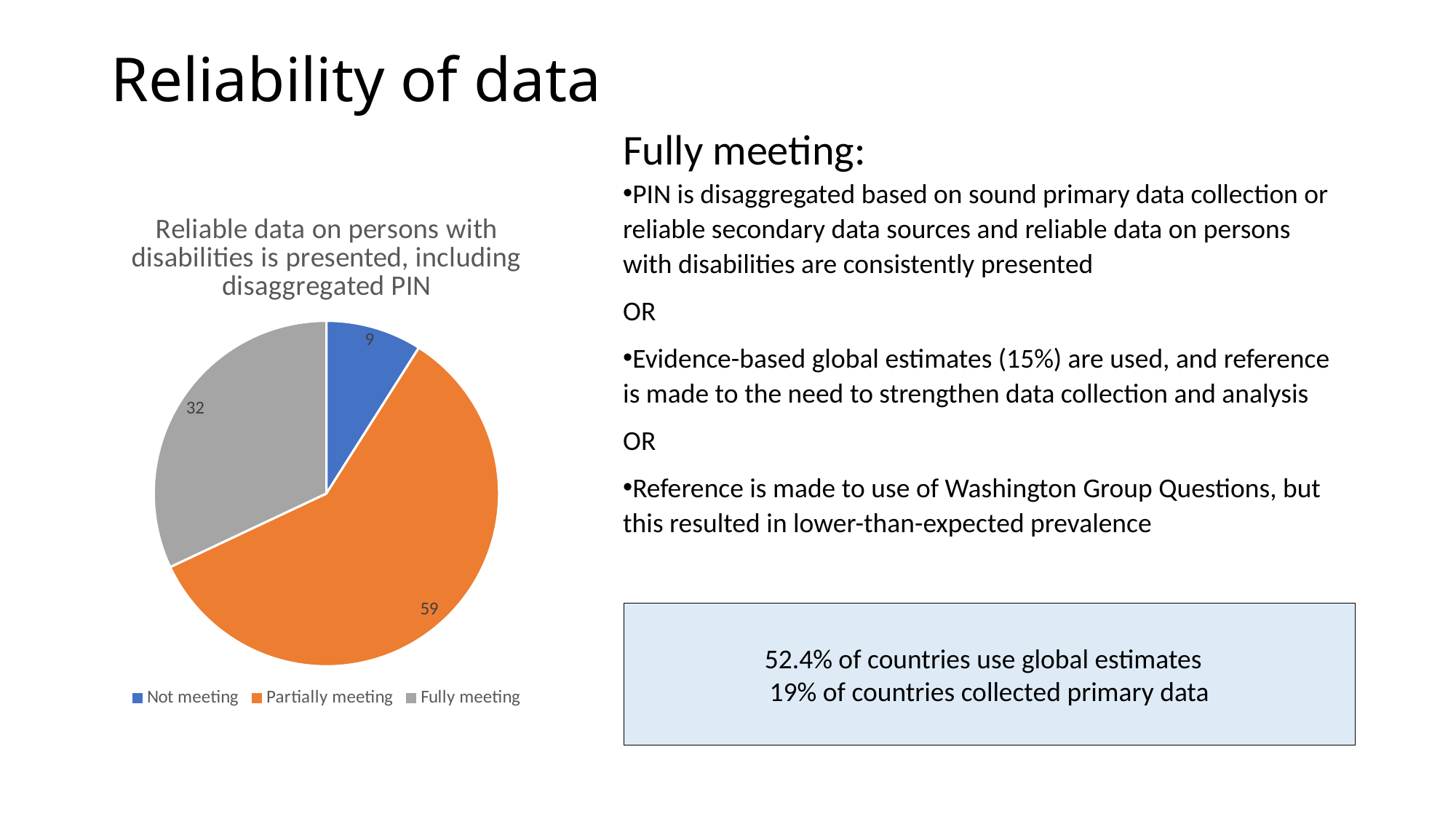
What share of the pie chart does the Partially meeting slice represent? 59% What colour is the Fully meeting slice in the pie chart? Grey Which category has the smallest slice in the pie chart? Not meeting How many categories does the pie chart show? 3 What type of chart is shown on the slide? Pie chart What is the difference between the Partially meeting and Fully meeting values in the pie chart? 27 What value is shown for the Partially meeting slice of the pie chart? 59 What is the difference between the Fully meeting and Not meeting values in the pie chart? 23 Which category has the largest slice in the pie chart? Partially meeting What value is shown for the Not meeting slice of the pie chart? 9 Which is larger in the pie chart, Fully meeting or Not meeting? Fully meeting What value is shown for the Fully meeting slice of the pie chart? 32